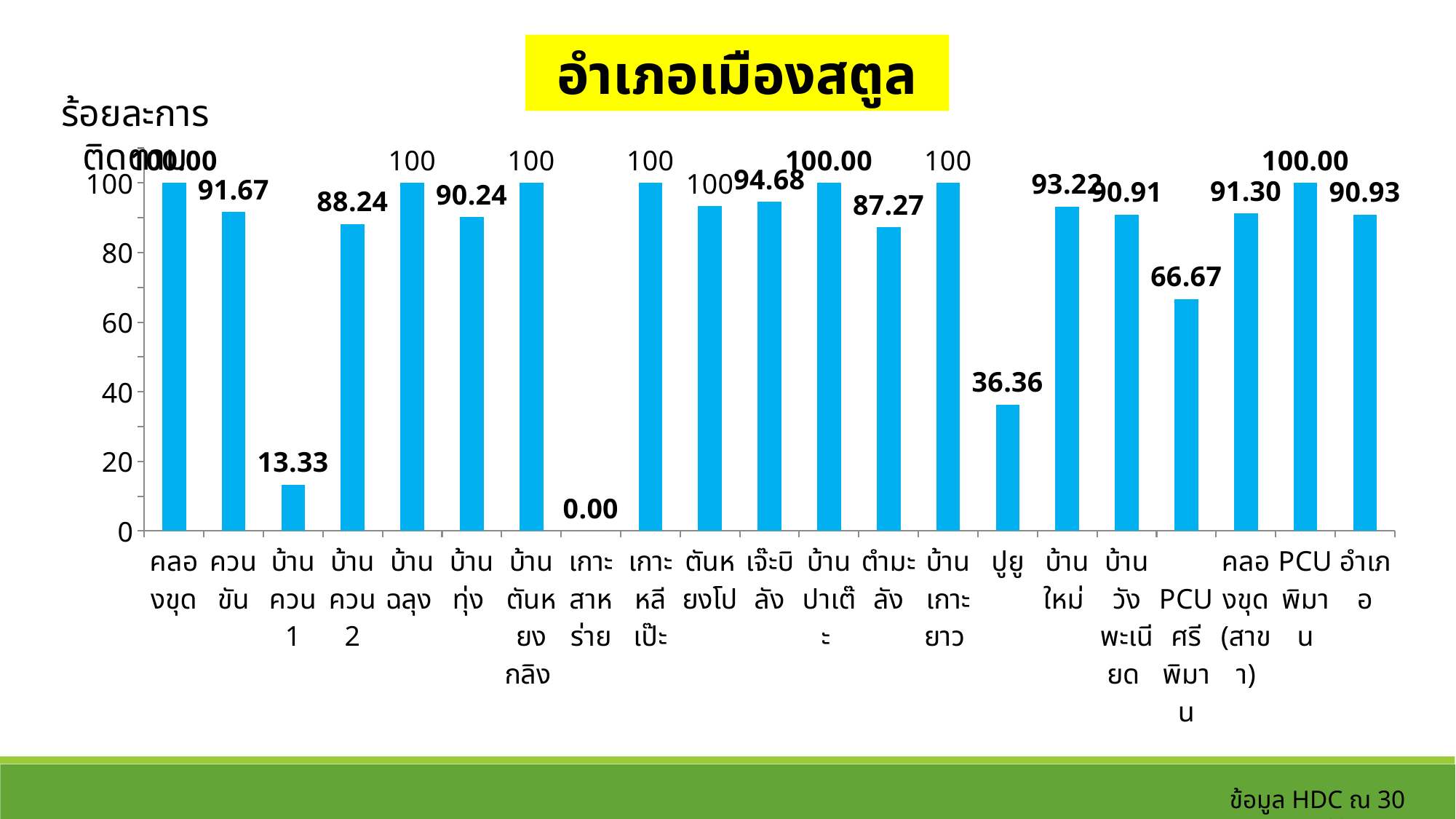
Is the value for ปูยู greater or less than 40? less What is the value for PCU ศรีพิมาน? 66.67 What is the value for บ้านควน 1? 13.33 What is the value for ตำมะลัง? 87.27 What is the difference between the values for PCU ศรีพิมาน and ปูยู? 30.31 How many categories are shown on the x axis? 21 What is the value for อำเภอ? 90.93 What kind of chart is shown on the slide? bar chart What is the value for ปูยู? 36.36 Which category has the lowest value? เกาะสาหร่าย Which is larger, the value for ควนขัน or the value for ตำมะลัง? ควนขัน What is the difference between the values for ปูยู and บ้านควน 1? 23.03